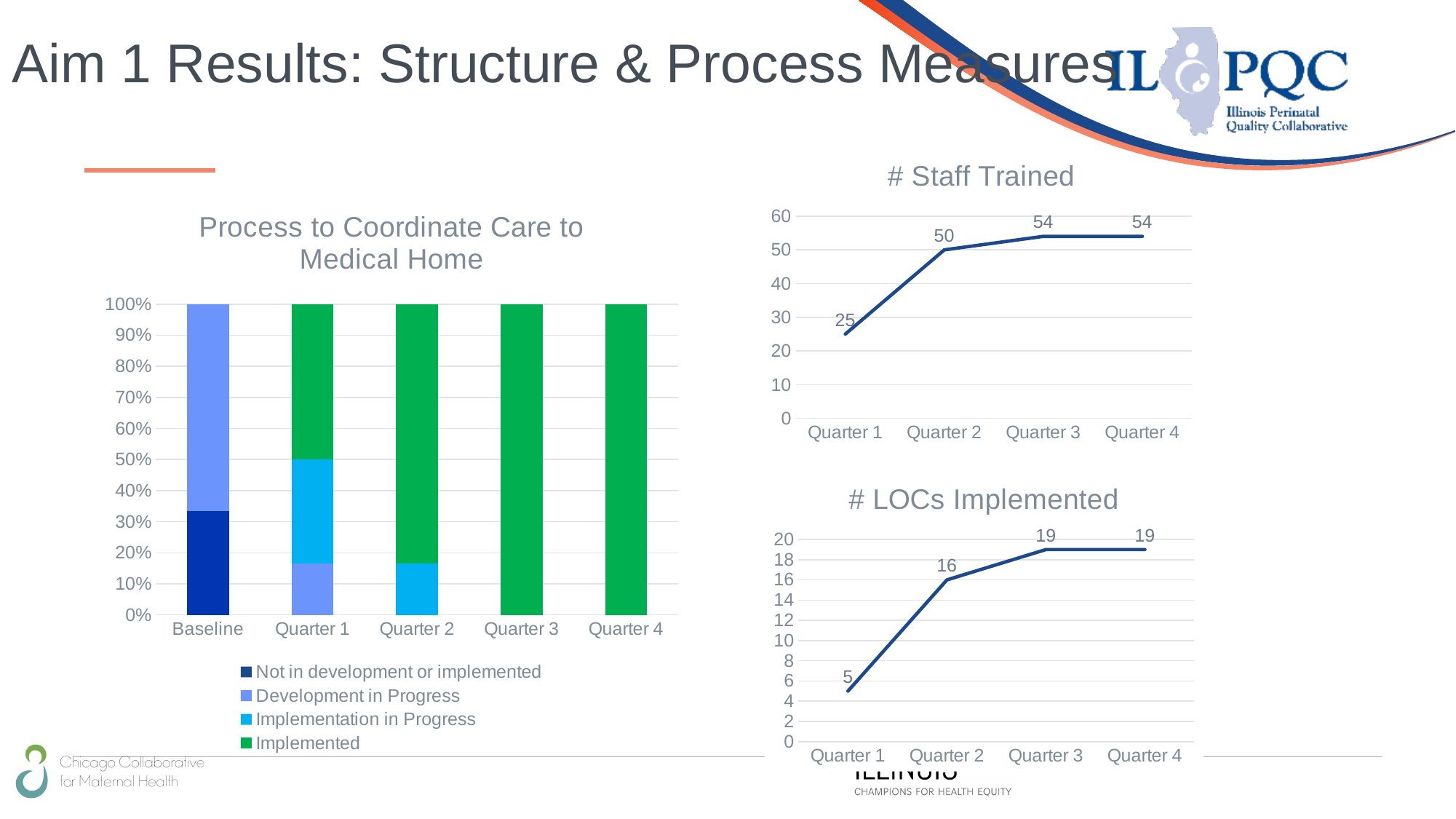
In the '# LOCs Implemented' chart, what is the value for Quarter 4? 19 In the '# Staff Trained' chart, what is the value for Quarter 1? 25 In the '# LOCs Implemented' chart, which quarter has the lowest value? Quarter 1 In the 'Process to Coordinate Care to Medical Home' chart, is the 'Not in development or implemented' share for Baseline greater or less than 50%? less In the 'Process to Coordinate Care to Medical Home' chart, how many series does the legend list? 4 In the '# LOCs Implemented' chart, what is the difference between Quarter 2 and Quarter 1? 11 What kind of chart is 'Process to Coordinate Care to Medical Home'? stacked bar chart In the '# LOCs Implemented' chart, what is the value for Quarter 1? 5 In the '# Staff Trained' chart, do the values rise or fall from Quarter 1 to Quarter 4? rise In the '# LOCs Implemented' chart, how many quarters are plotted? 4 In the '# Staff Trained' chart, what is the difference between Quarter 3 and Quarter 1? 29 In the '# Staff Trained' chart, what is the value for Quarter 2? 50